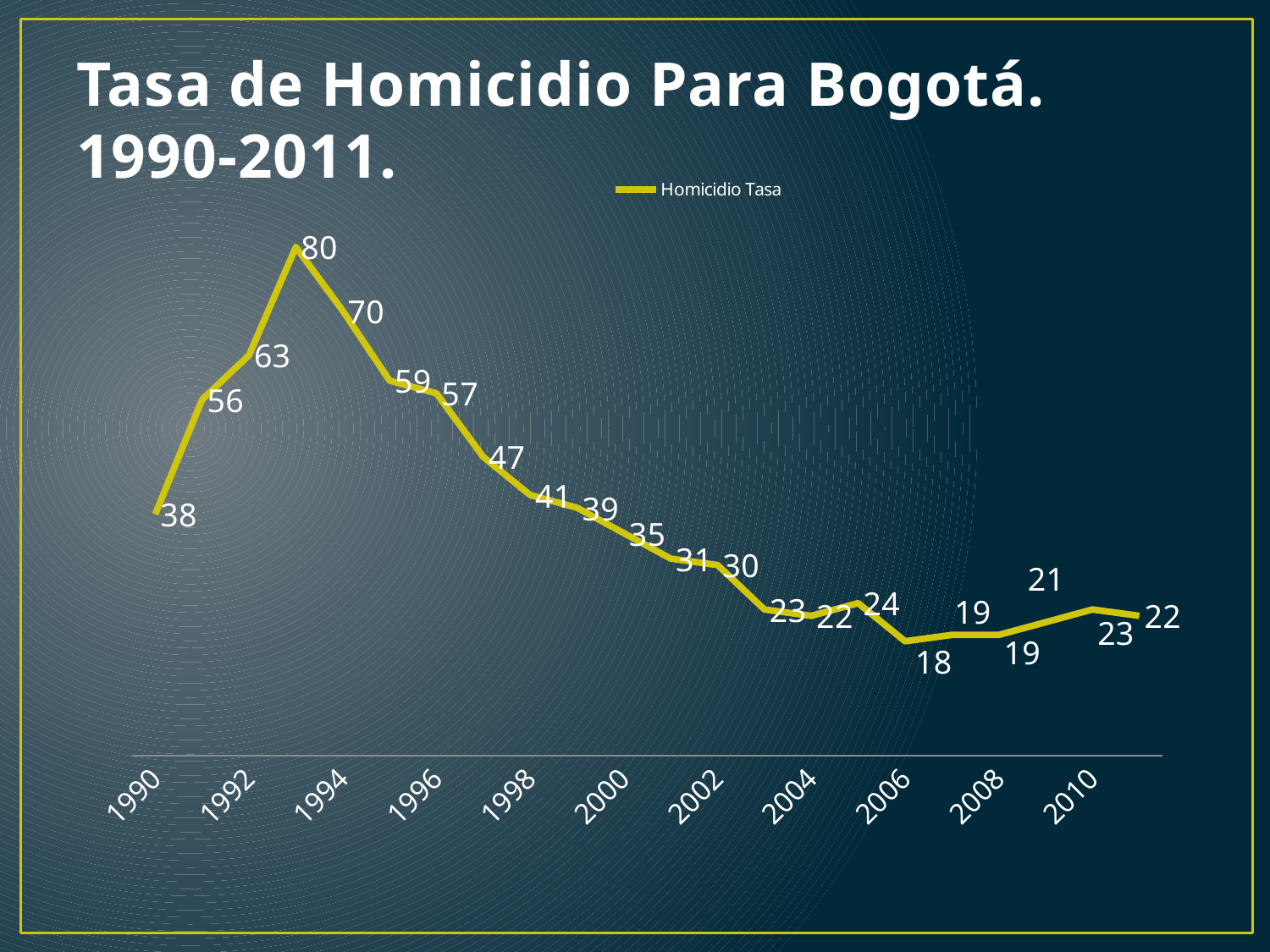
What is the difference between the value for 1990 and the value for 2010? 15 What is the value plotted for 2006? 18 What kind of chart is shown on the slide? Line chart How many series does the legend list? 1 What is the lowest value shown on the line? 18 What is the value plotted for 2000? 35 What is the homicide rate value shown for 1990? 38 Which year has the larger value, 1994 or 2004? 1994 Do the values rise or fall between 1994 and 2006? Fall How many data points are plotted on the line? 22 What is the highest value shown on the line? 80 What is the value plotted for 2010? 23